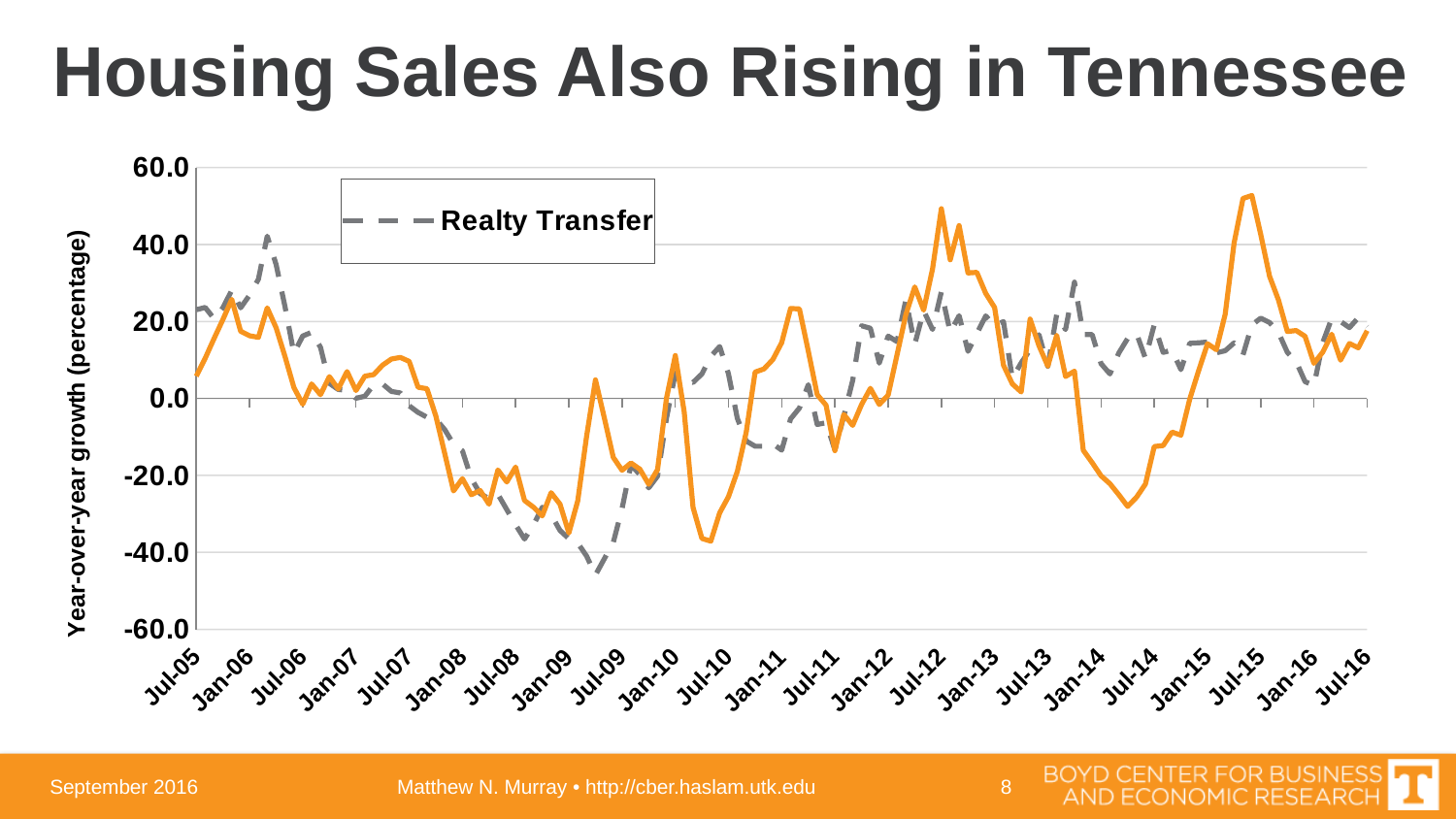
Is the lowest value of the Realty Transfer line, reached around Jul-09, greater or less than -40.0? less Does the solid orange line rise or fall between Jan-15 and Jul-15? rise Is the peak of the solid orange line around Jul-15 greater or less than 40.0? greater Is the value of the solid orange line around Jul-14 greater or less than -20.0? greater Around Jul-09, which line is higher: the solid orange line or the dashed Realty Transfer line? the solid orange line What is the name of the series shown in the legend? Realty Transfer What is the label on the vertical axis of the chart? Year-over-year growth (percentage) How many date labels are shown along the x axis? 23 How many series does the chart's legend list? 1 What kind of chart is shown on the slide? line chart